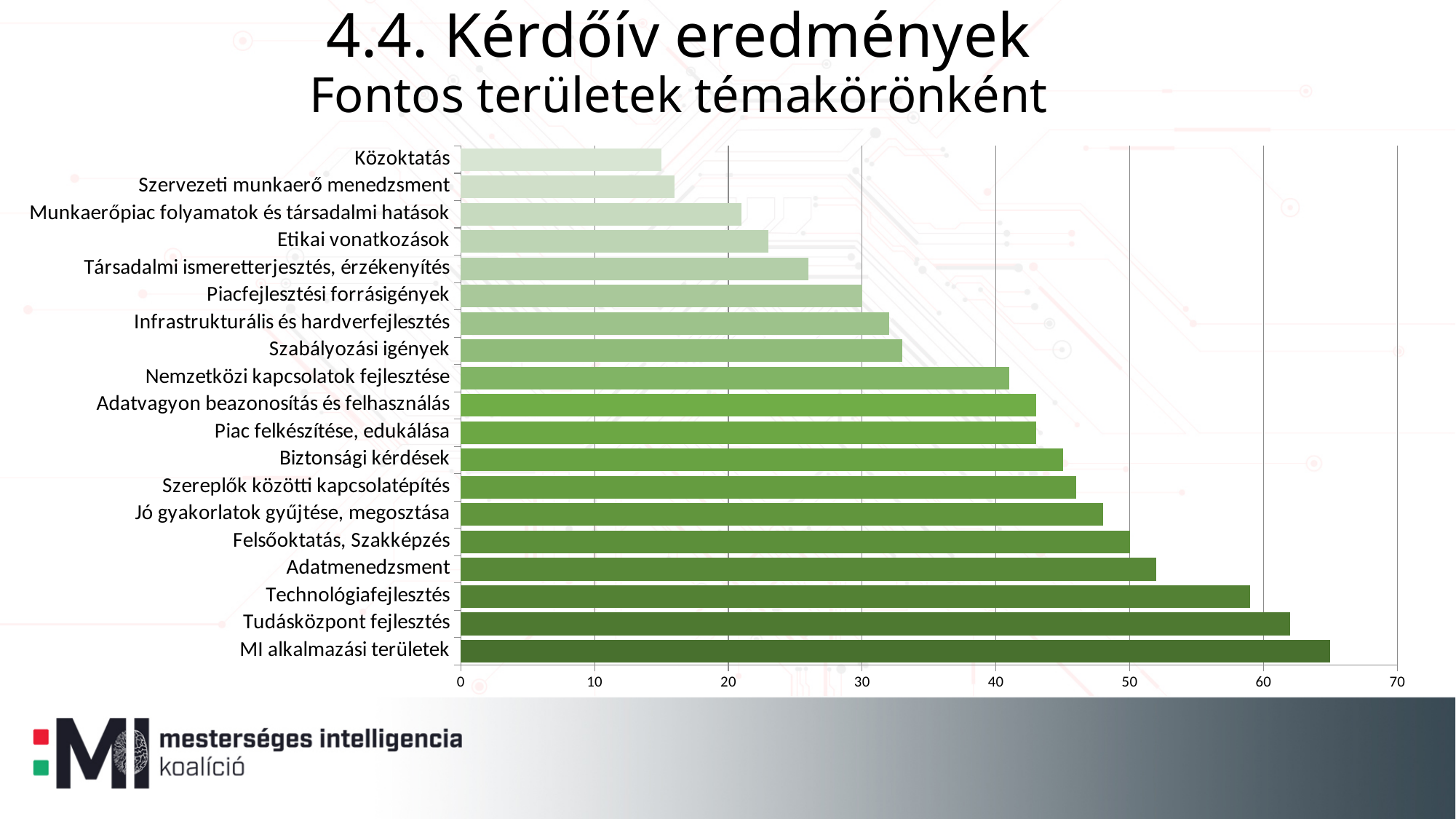
Which has a larger value, Közoktatás or Munkaerőpiac folyamatok és társadalmi hatások? Munkaerőpiac folyamatok és társadalmi hatások Which category has the lowest value? Közoktatás Is the value for Tudásközpont fejlesztés greater or less than 60? greater What is the subtitle of the chart slide below '4.4. Kérdőív eredmények'? Fontos területek témakörönként Is the value for Technológiafejlesztés greater or less than 50? greater Do the bar values increase or decrease going from the top category to the bottom category? increase Is the value for Etikai vonatkozások greater or less than 30? less Which category has the highest value? MI alkalmazási területek What kind of chart is shown on the slide? bar chart Which has a larger value, Adatmenedzsment or Szabályozási igények? Adatmenedzsment How many categories are plotted in the chart? 19